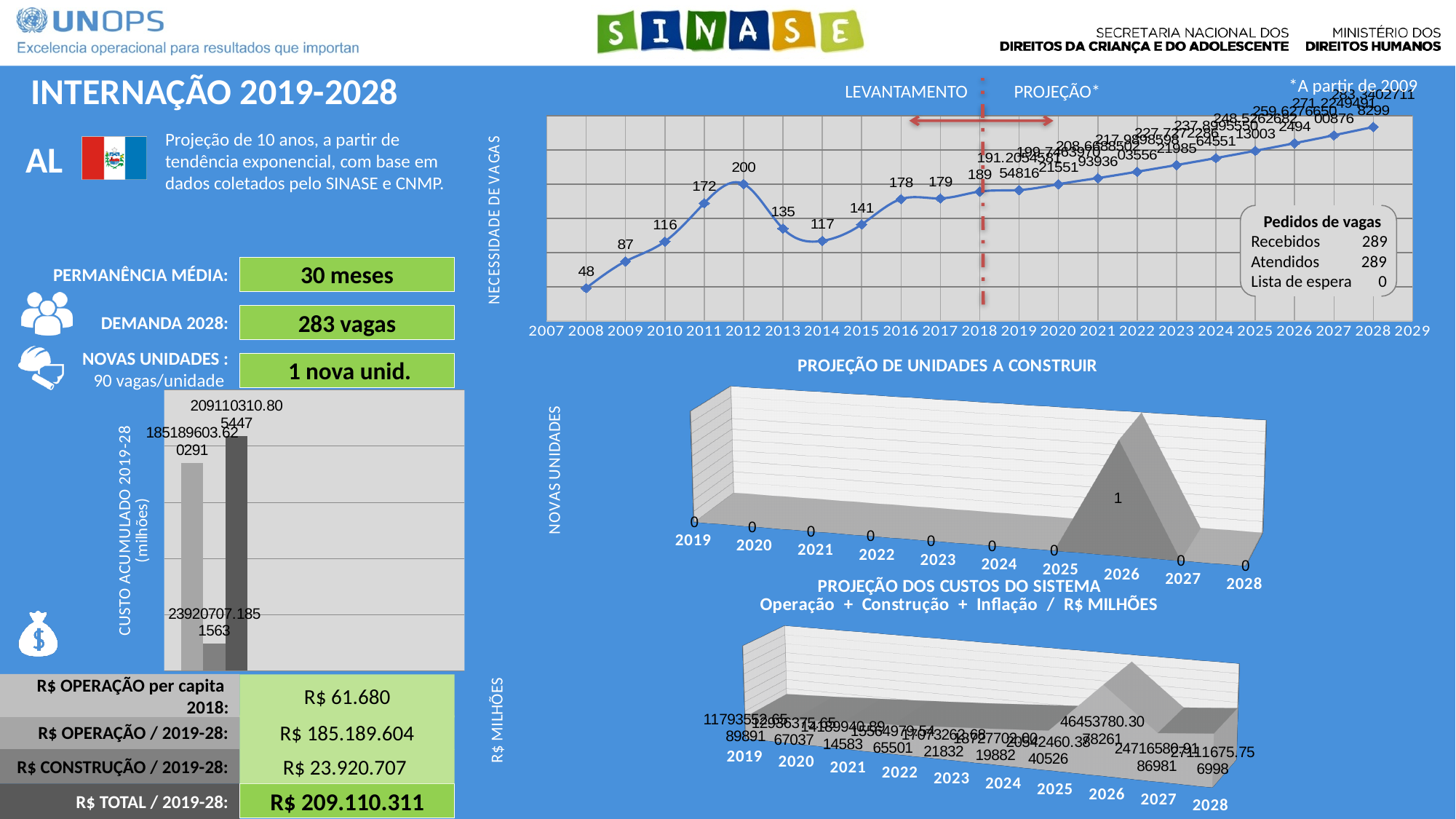
In the NECESSIDADE DE VAGAS line chart, which year has the lowest value? 2008 How many years are shown on the x axis of the PROJEÇÃO DE UNIDADES A CONSTRUIR chart? 10 In the NECESSIDADE DE VAGAS line chart, what is the value for 2018? 189 In the PROJEÇÃO DE UNIDADES A CONSTRUIR chart, what is the value for 2026? 1 In the PROJEÇÃO DE UNIDADES A CONSTRUIR chart, which year has the highest value? 2026 In the NECESSIDADE DE VAGAS line chart, which is larger, the value for 2011 or the value for 2014? 2011 In the NECESSIDADE DE VAGAS line chart, what is the value for 2012? 200 What is the y-axis label of the line chart at the top right of the slide? NECESSIDADE DE VAGAS What kind of chart is the NECESSIDADE DE VAGAS chart at the top right? line chart In the NECESSIDADE DE VAGAS line chart, what is the difference between the values for 2012 and 2013? 65 In the NECESSIDADE DE VAGAS line chart, what is the value for 2008? 48 In the NECESSIDADE DE VAGAS line chart, do the values rise or fall from 2018 to 2028? rise